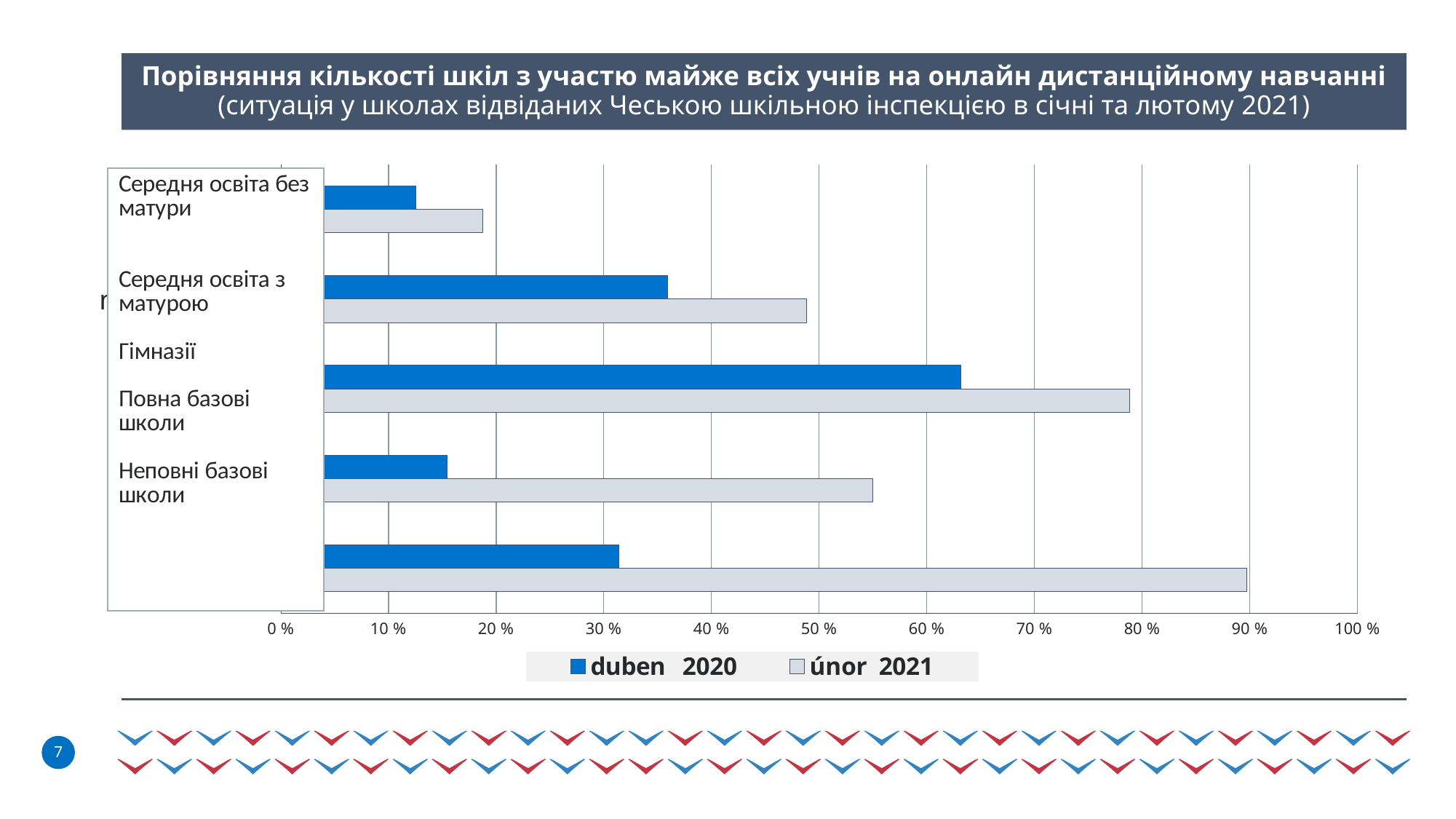
For Середня освіта з матурою, which series has the larger value, duben 2020 or únor 2021? únor 2021 Is the duben 2020 value in the bottom group of bars greater or less than 40 %? less How many series does the legend list? 2 Which series has the longest bar on the chart? únor 2021 Is the únor 2021 value for Середня освіта з матурою greater or less than 40 %? greater What is the highest value shown on the x axis? 100 % Is the únor 2021 value for Середня освіта без матури greater or less than 10 %? greater How many groups of bars are plotted on the chart? 5 What kind of chart is shown on the slide? bar chart What are the two series named in the legend? duben 2020 and únor 2021